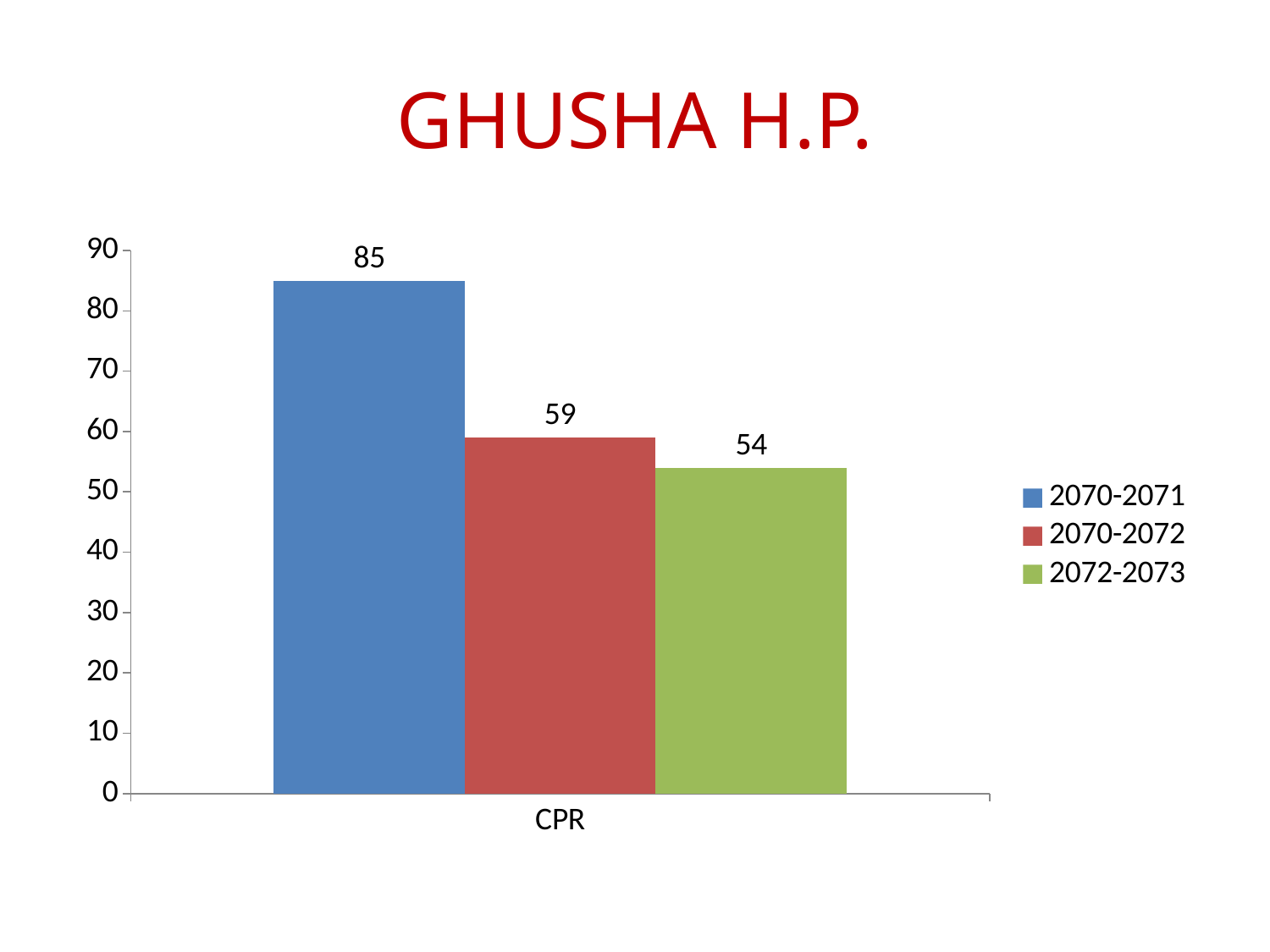
How many series does the legend list? 3 What is the title of the slide? GHUSHA H.P. What is the difference between the CPR values for 2070-2072 and 2072-2073? 5 What is the CPR value for the 2070-2072 series? 59 Which is larger, the CPR value for 2070-2071 or for 2070-2072? 2070-2071 Is the CPR value for 2070-2072 greater or less than 50? greater What is the difference between the CPR values for 2070-2071 and 2072-2073? 31 Which series has the highest CPR value? 2070-2071 Which series has the lowest CPR value? 2072-2073 What is the CPR value for the 2072-2073 series? 54 What kind of chart is shown on the slide? bar chart What is the CPR value for the 2070-2071 series? 85